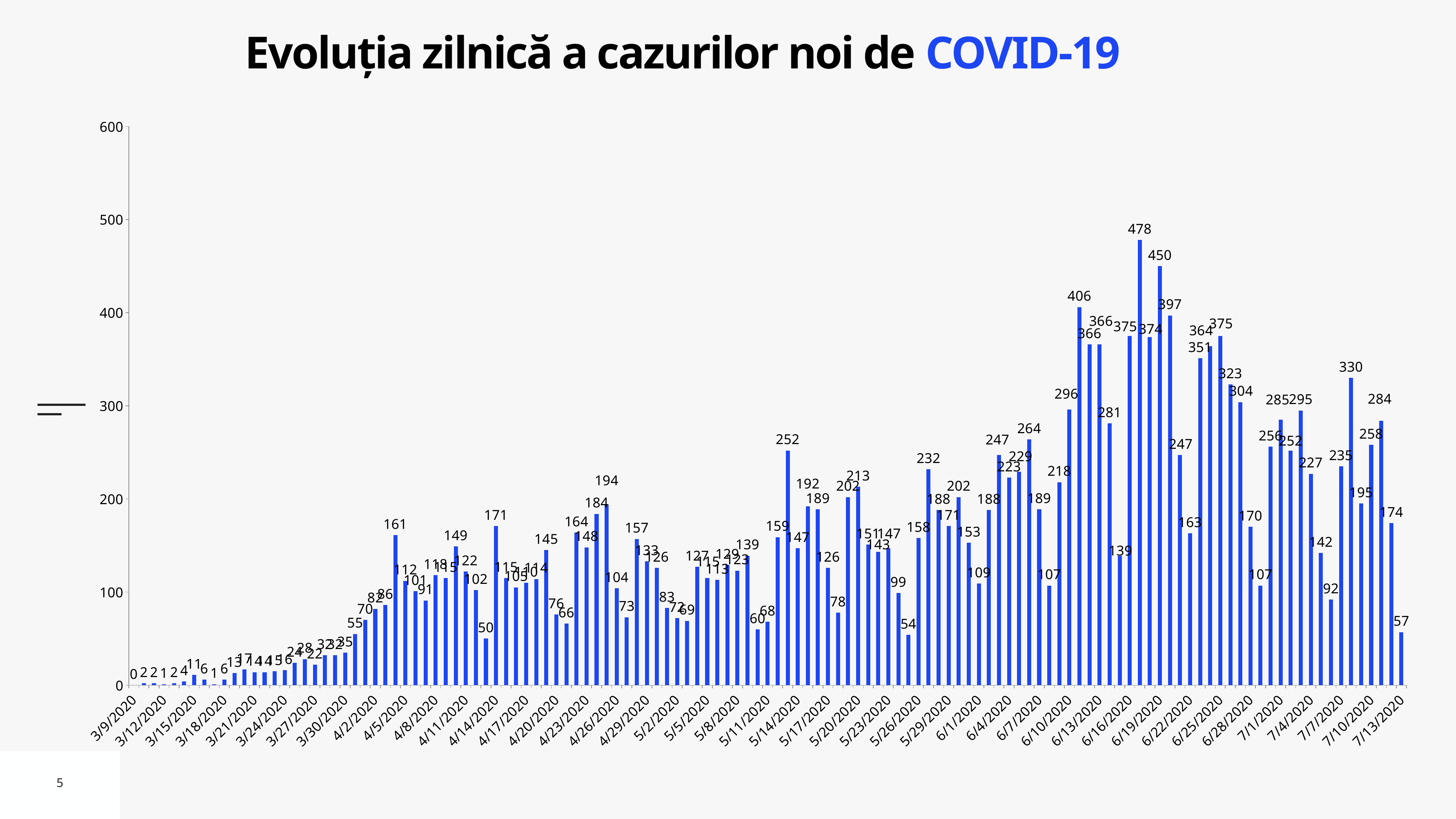
Is the highest bar in the chart greater or less than 500? less What is the value of the last bar, for 7/13/2020? 57 What kind of chart is shown on the slide? bar chart Which is larger, the bar labelled 406 or the bar labelled 397? 406 What is the value of the first bar, for 3/9/2020? 0 Do the daily values generally rise or fall from March to mid-June 2020? rise What is the title of the chart? Evoluția zilnică a cazurilor noi de COVID-19 What is the second-highest daily value shown in the chart? 450 What is the difference between the bar labelled 406 and the bar labelled 366 next to it? 40 What is the difference between the two highest bars, 478 and 450? 28 How many bars have a value above 400? 3 What is the highest daily value shown in the chart? 478